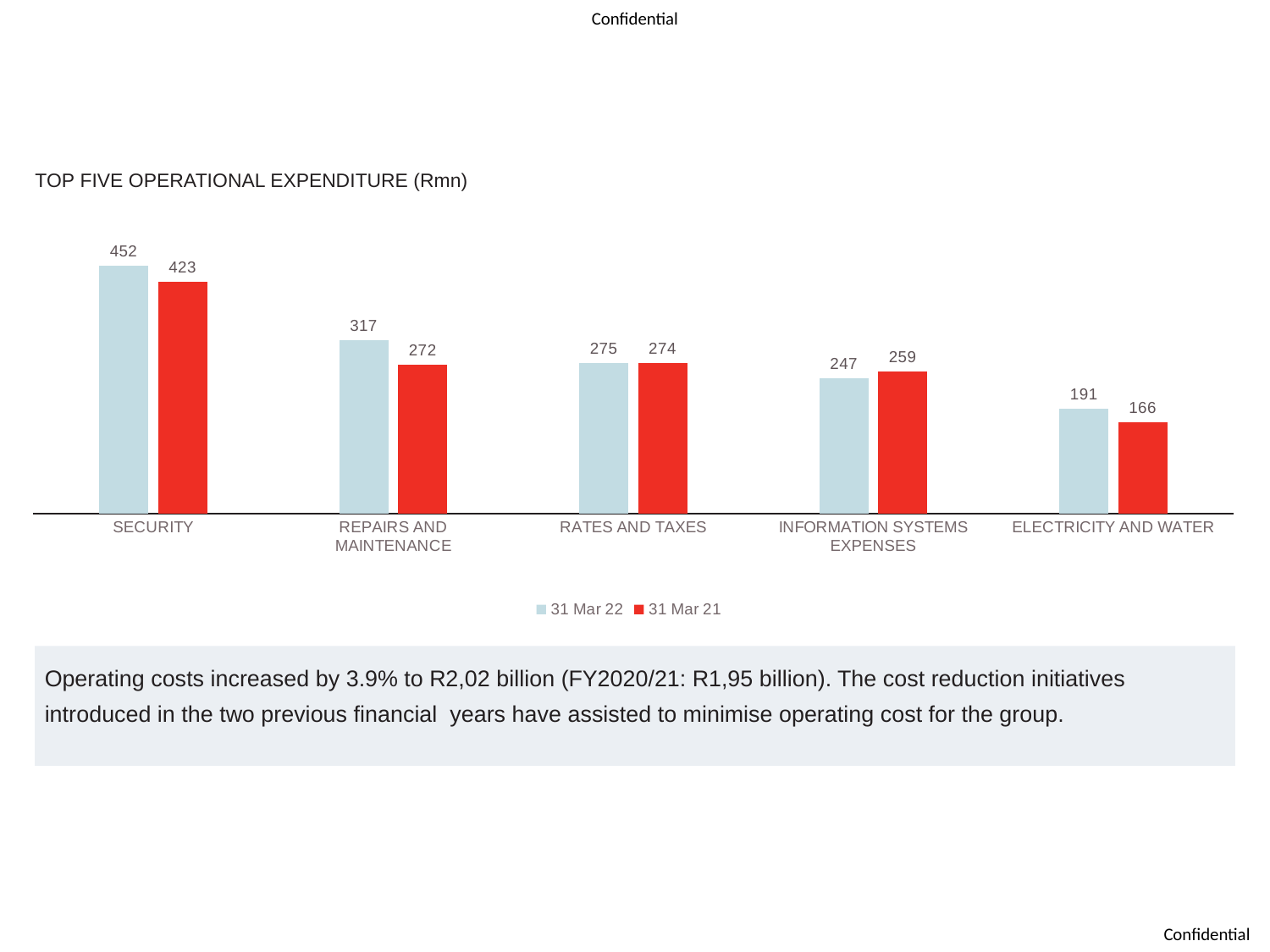
How many categories are shown on the x axis? 5 Which category has the lowest value in the 31 Mar 21 series? Electricity and Water What is the difference between the 31 Mar 22 and 31 Mar 21 values for Security? 29 What is the title of the chart? TOP FIVE OPERATIONAL EXPENDITURE (Rmn) What kind of chart is shown on the slide? Bar chart What is the value for Electricity and Water in the 31 Mar 22 series? 191 What is the value for Security in the 31 Mar 22 series? 452 For Information Systems Expenses, which series has the larger value, 31 Mar 22 or 31 Mar 21? 31 Mar 21 Which category has the highest value in the 31 Mar 22 series? Security What is the difference between the 31 Mar 22 and 31 Mar 21 values for Repairs and Maintenance? 45 How many series does the legend list? 2 What is the value for Repairs and Maintenance in the 31 Mar 21 series? 272